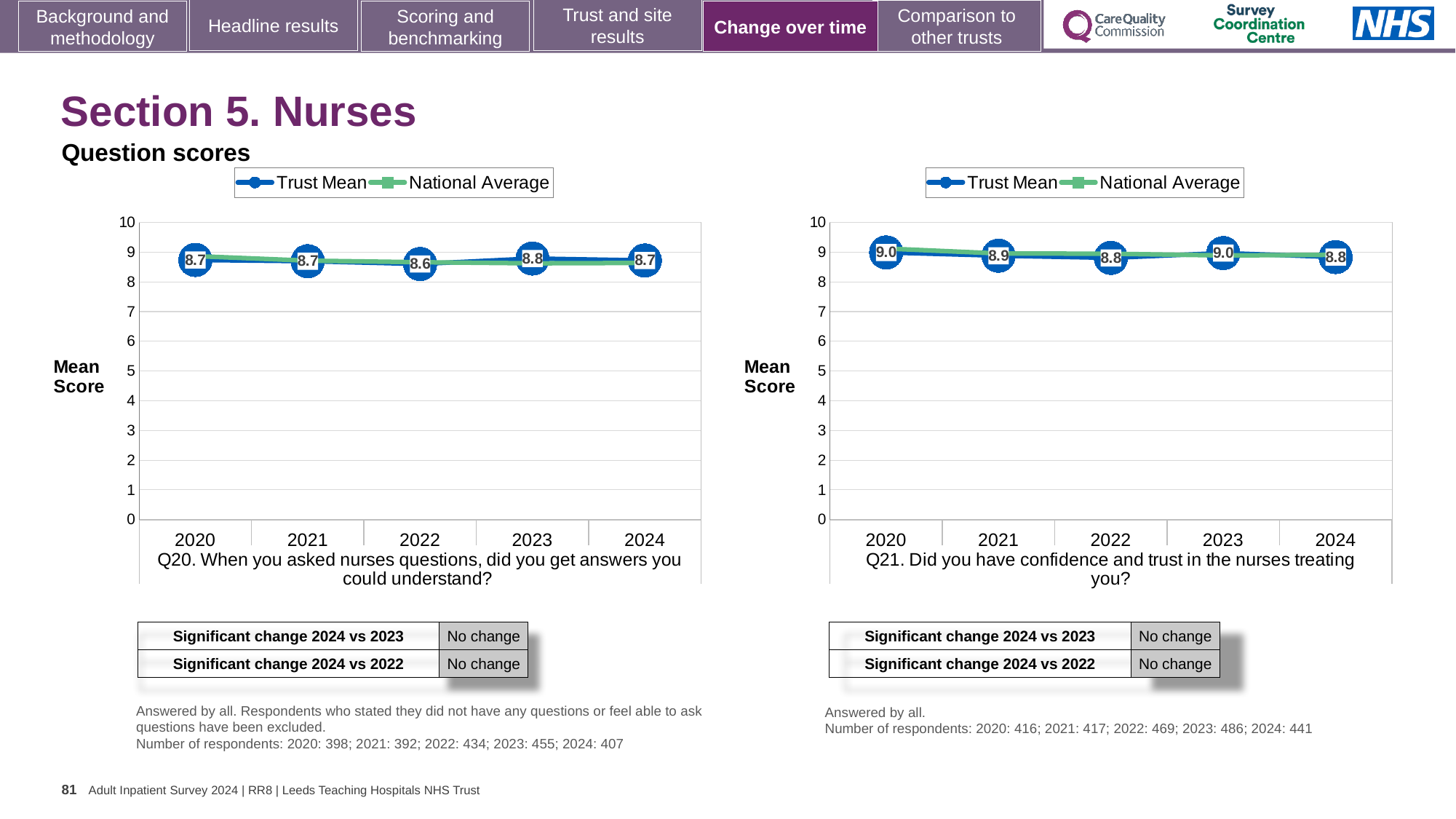
In the Q21 chart (right), what is the difference between the Trust Mean scores for 2020 and 2022? 0.2 In the Q20 chart (left), what is the Trust Mean score for 2022? 8.6 How many years are plotted on the x axis of the Q21 chart (right)? 5 In the Q20 chart (left), which year has the lowest Trust Mean score? 2022 In the Q21 chart (right), is the Trust Mean score for 2021 larger or smaller than the score for 2022? larger How many series does the legend of the Q20 chart (left) list? 2 What type of chart is used for Q21 (right)? Line chart In the Q20 chart (left), what is the Trust Mean score for 2023? 8.8 In the Q20 chart (left), is the Trust Mean score for 2024 greater or less than 8? greater In the Q21 chart (right), what is the Trust Mean score for 2020? 9.0 In the Q20 chart (left), which year has the highest Trust Mean score? 2023 In the Q21 chart (right), what is the Trust Mean score for 2024? 8.8